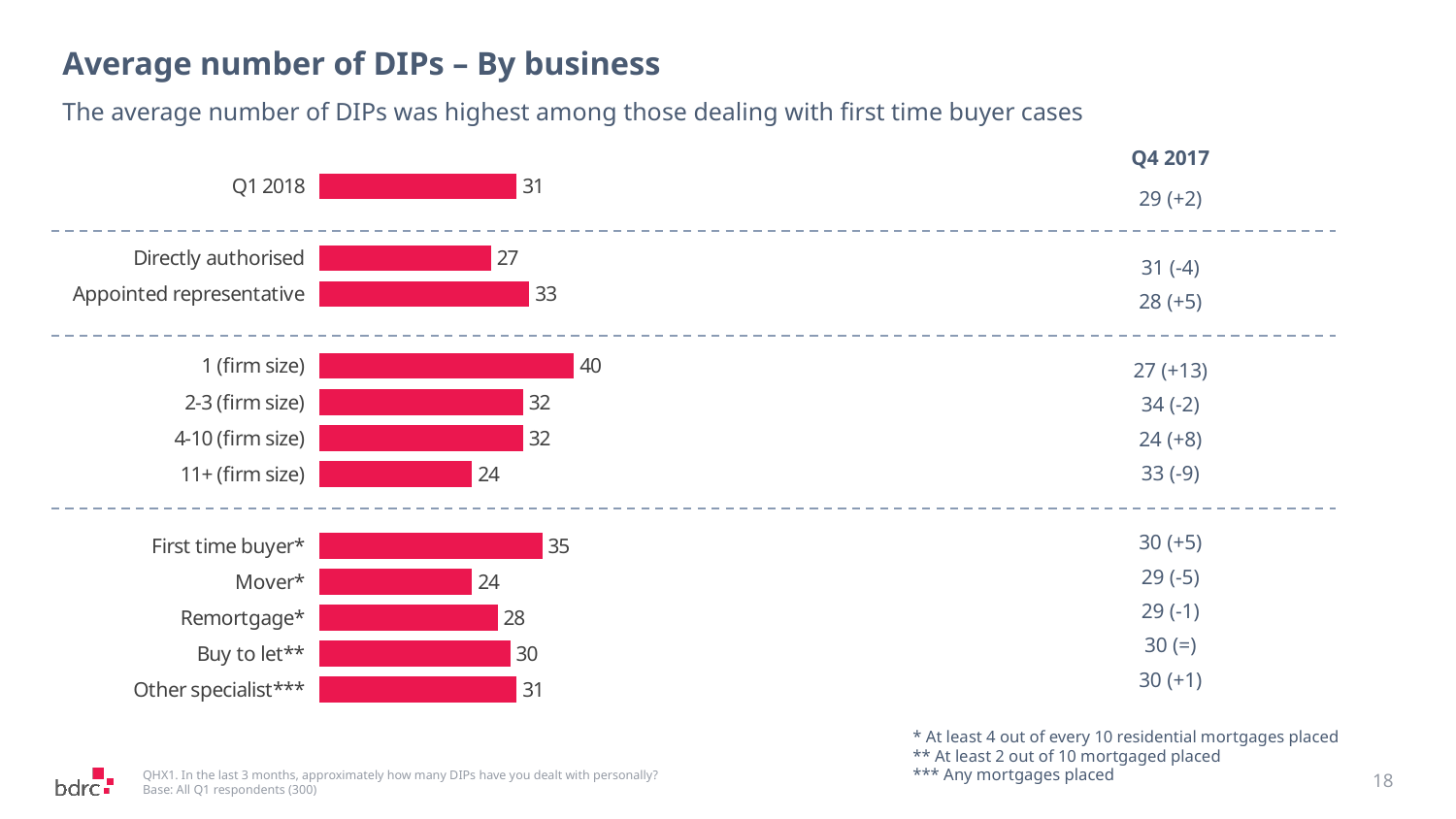
What is the value shown for First time buyer*? 35 Which is larger, the value for Directly authorised or for Appointed representative? Appointed representative What is the title of the slide's chart? Average number of DIPs – By business How many bars are plotted on the chart? 12 Which category has the highest average number of DIPs? 1 (firm size) Which of the firm size categories has the lowest value? 11+ (firm size) What type of chart is shown on the slide? Bar chart What is the difference between the values for First time buyer* and Mover*? 11 What is the average number of DIPs for Appointed representative? 33 What is the value shown for Buy to let**? 30 What is the difference between the values for 1 (firm size) and 11+ (firm size)? 16 What is the value shown for 1 (firm size)? 40